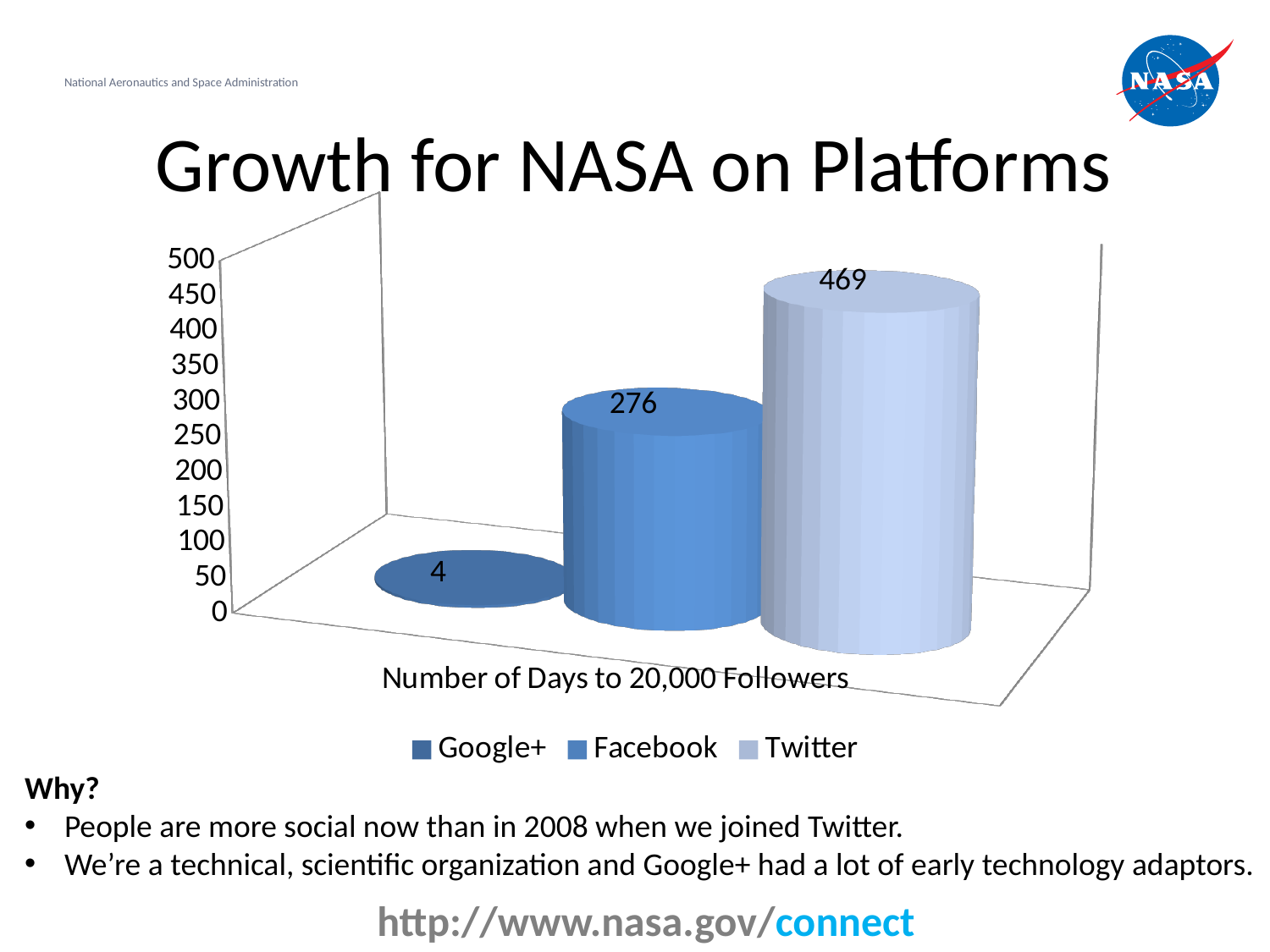
What kind of chart is shown on the slide? bar chart What is the category label shown on the x axis of the chart? Number of Days to 20,000 Followers Is the value for Twitter greater or less than 400? greater What is the difference in days between Facebook and Google+ reaching 20,000 followers? 272 How many days did it take Twitter to reach 20,000 followers? 469 Which platform took the most days to reach 20,000 followers? Twitter How many series does the legend list? 3 How many days did it take Facebook to reach 20,000 followers? 276 Which took more days to reach 20,000 followers, Facebook or Google+? Facebook How many days did it take Google+ to reach 20,000 followers? 4 What is the difference in days between Twitter and Facebook reaching 20,000 followers? 193 Which platform took the fewest days to reach 20,000 followers? Google+